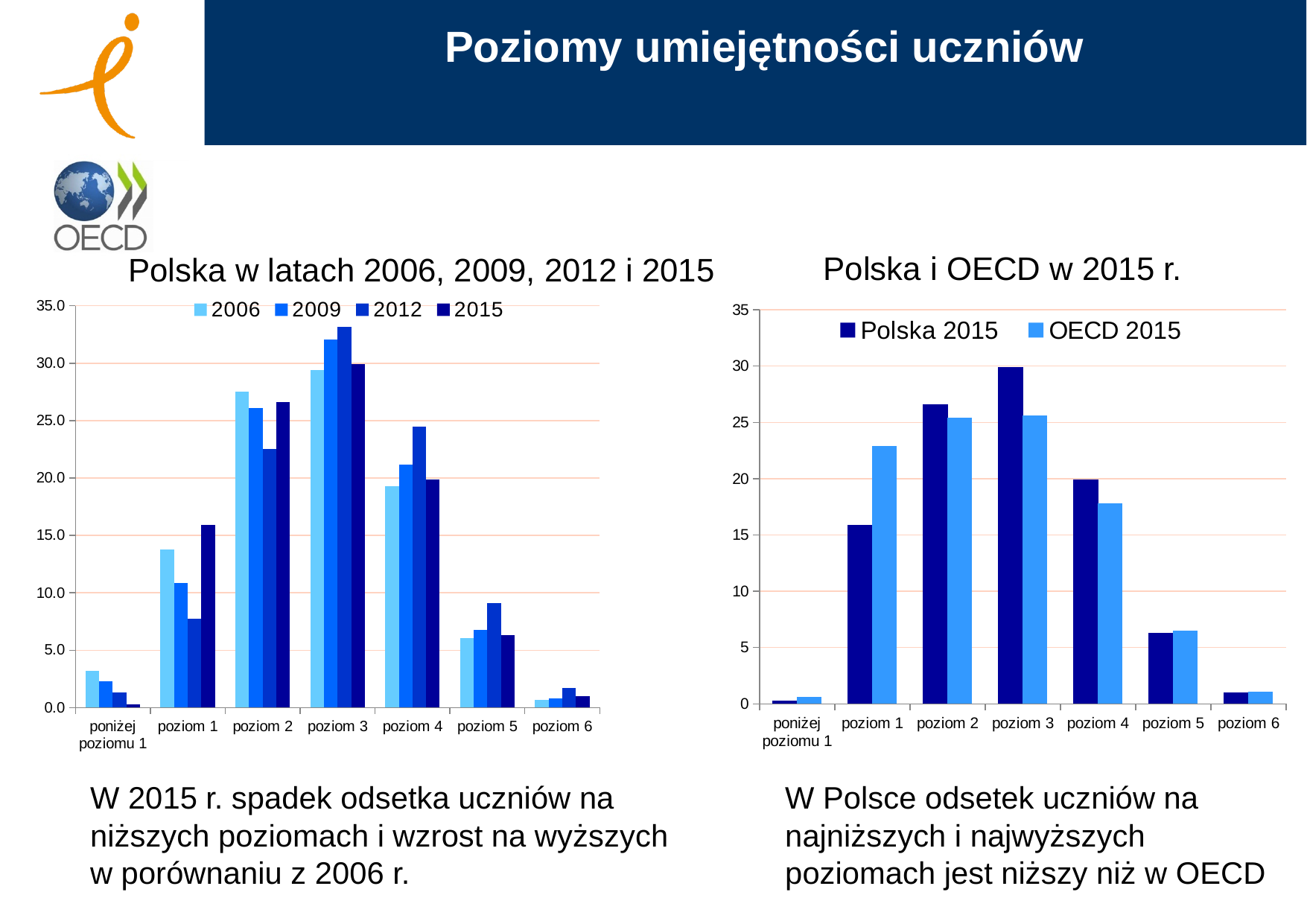
In the chart titled "Polska w latach 2006, 2009, 2012 i 2015", which series has the highest value at poziom 1? 2015 In the chart titled "Polska i OECD w 2015 r.", at poziom 1, which is larger: Polska 2015 or OECD 2015? OECD 2015 In the chart titled "Polska w latach 2006, 2009, 2012 i 2015", how many series does the legend list? 4 What kind of chart is the chart titled "Polska w latach 2006, 2009, 2012 i 2015"? bar chart In the chart titled "Polska i OECD w 2015 r.", which category has the lowest value for OECD 2015? poniżej poziomu 1 In the chart titled "Polska i OECD w 2015 r.", is the value for Polska 2015 at poziom 1 greater or less than 15? greater In the chart titled "Polska i OECD w 2015 r.", how many categories are shown on the x axis? 7 In the chart titled "Polska w latach 2006, 2009, 2012 i 2015", at poziom 4, which is larger: 2006 or 2012? 2012 In the chart titled "Polska i OECD w 2015 r.", is the value for OECD 2015 at poziom 4 greater or less than 20? less In the chart titled "Polska i OECD w 2015 r.", how many series does the legend list? 2 In the chart titled "Polska i OECD w 2015 r.", which category has the highest value for Polska 2015? poziom 3 In the chart titled "Polska w latach 2006, 2009, 2012 i 2015", is the value for 2012 at poziom 3 greater or less than 30.0? greater